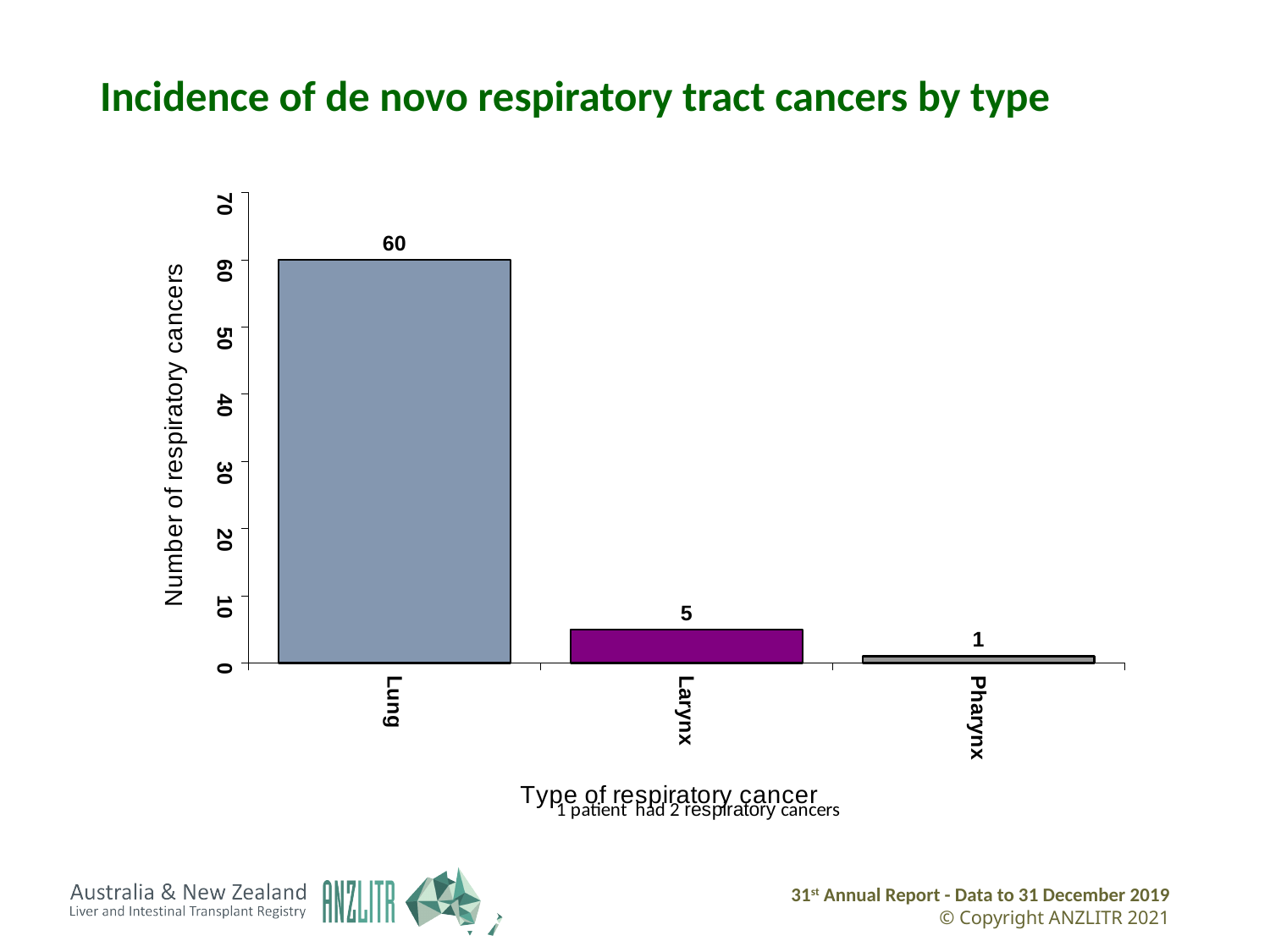
What is the number of respiratory cancers for Larynx? 5 What is the difference between the number of Lung cancers and Larynx cancers? 55 What kind of chart is shown on the slide? Bar chart Is the value for Lung greater or less than 50? greater What is the number of respiratory cancers for Lung? 60 How many types of respiratory cancer are shown on the chart? 3 What is the label of the y axis? Number of respiratory cancers Which type of respiratory cancer has the lowest number of cases? Pharynx Which has more cases, Larynx or Pharynx? Larynx What is the difference between the number of Larynx cancers and Pharynx cancers? 4 Which type of respiratory cancer has the highest number of cases? Lung What is the number of respiratory cancers for Pharynx? 1